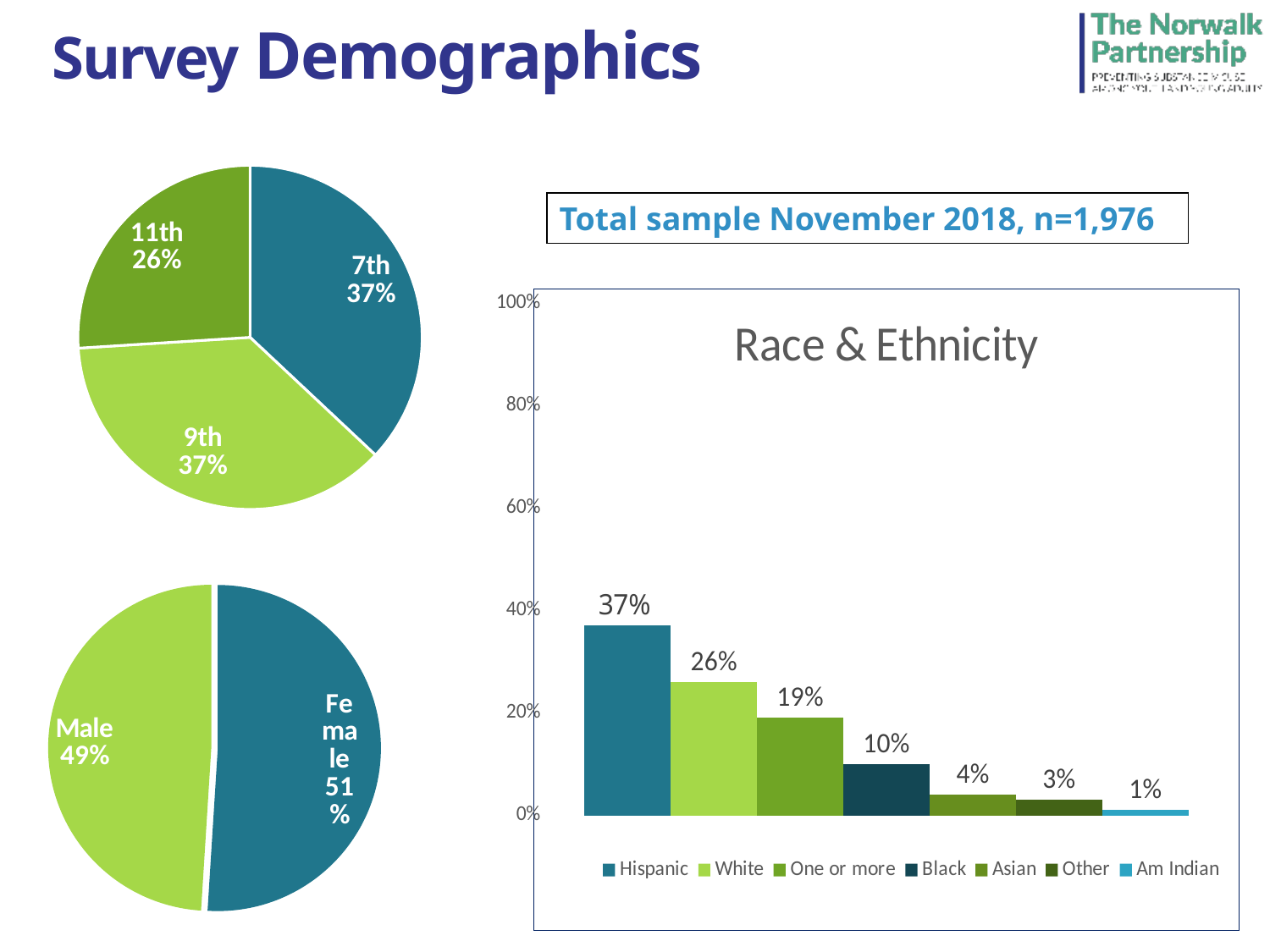
In the Race & Ethnicity bar chart, what is the difference between the values for White and One or more? 7% How many categories does the Race & Ethnicity bar chart show? 7 In the Race & Ethnicity bar chart, what is the value for Black? 10% In the Race & Ethnicity bar chart, what is the value for Hispanic? 37% In the Race & Ethnicity bar chart, do the values rise or fall from left to right? Fall In the top-left pie chart, what share does the 11th grade slice have? 26% In the Race & Ethnicity bar chart, which is larger, the value for Asian or the value for Other? Asian In the Race & Ethnicity bar chart, which category has the highest value? Hispanic What kind of chart is the Race & Ethnicity chart? Bar chart In the bottom-left pie chart, what share does the Male slice have? 49% What is the sample size stated on the slide for the total sample in November 2018? n=1,976 In the Race & Ethnicity bar chart, which category has the lowest value? Am Indian